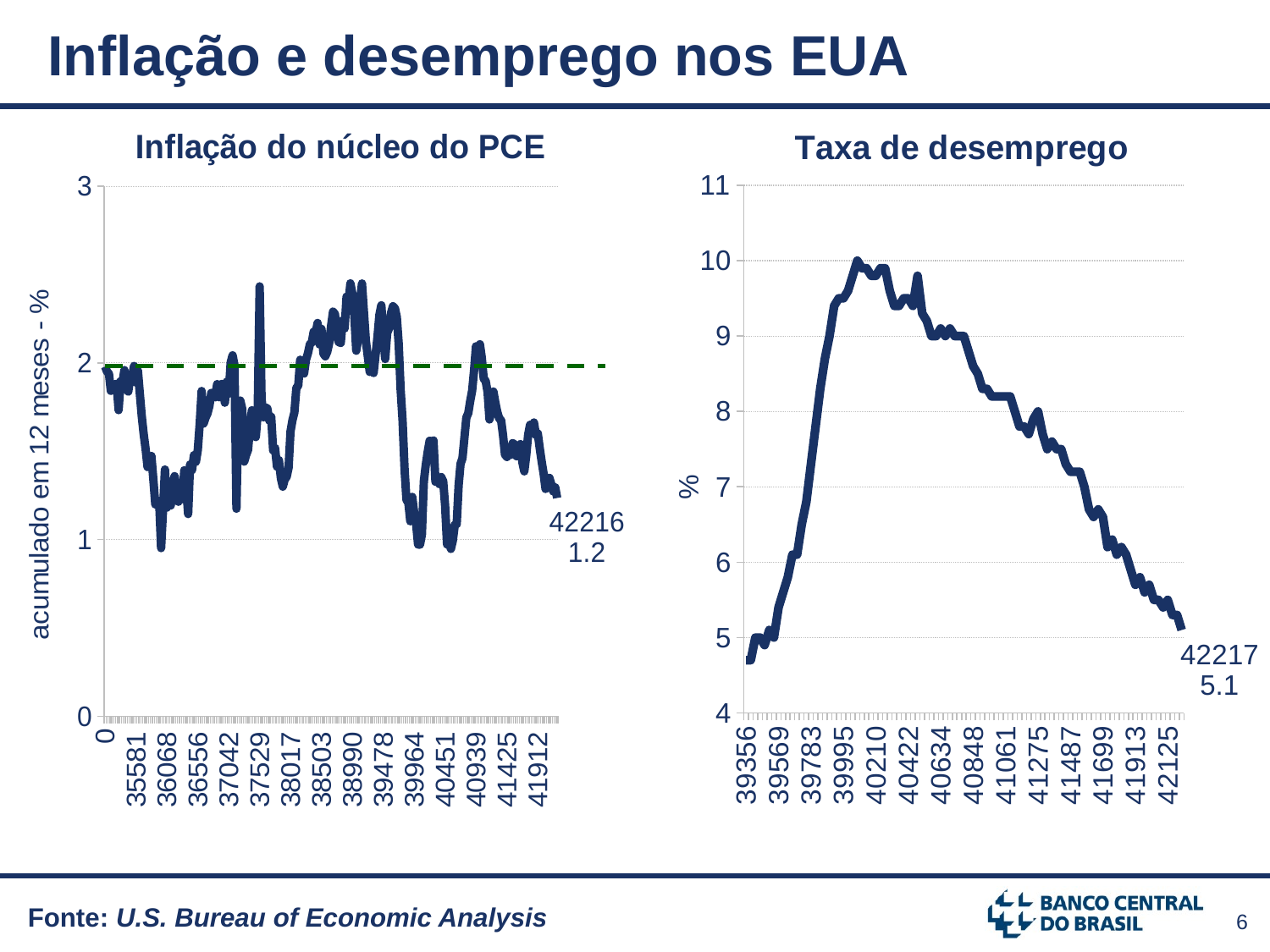
In the "Inflação do núcleo do PCE" chart, is the final value (at 42216) greater or less than 2? less What kind of chart is the "Taxa de desemprego" chart? line chart In the "Taxa de desemprego" chart, is the final value (5.1) greater or less than the peak value? less In the "Inflação do núcleo do PCE" chart, what is the value of the last labelled data point? 1.2 What is the y-axis label of the "Inflação do núcleo do PCE" chart? acumulado em 12 meses - % In the "Taxa de desemprego" chart, is the peak value of the line greater or less than 9? greater In the "Taxa de desemprego" chart, does the line rise or fall from its peak near 40210 to the end of the series? fall In the "Taxa de desemprego" chart, is the value at the start of the series (39356) greater or less than 5? less What kind of chart is the "Inflação do núcleo do PCE" chart? line chart How many charts are shown on the slide? 2 In the "Inflação do núcleo do PCE" chart, at what level is the dashed horizontal line drawn? 2 In the "Taxa de desemprego" chart, what is the value of the last labelled data point? 5.1